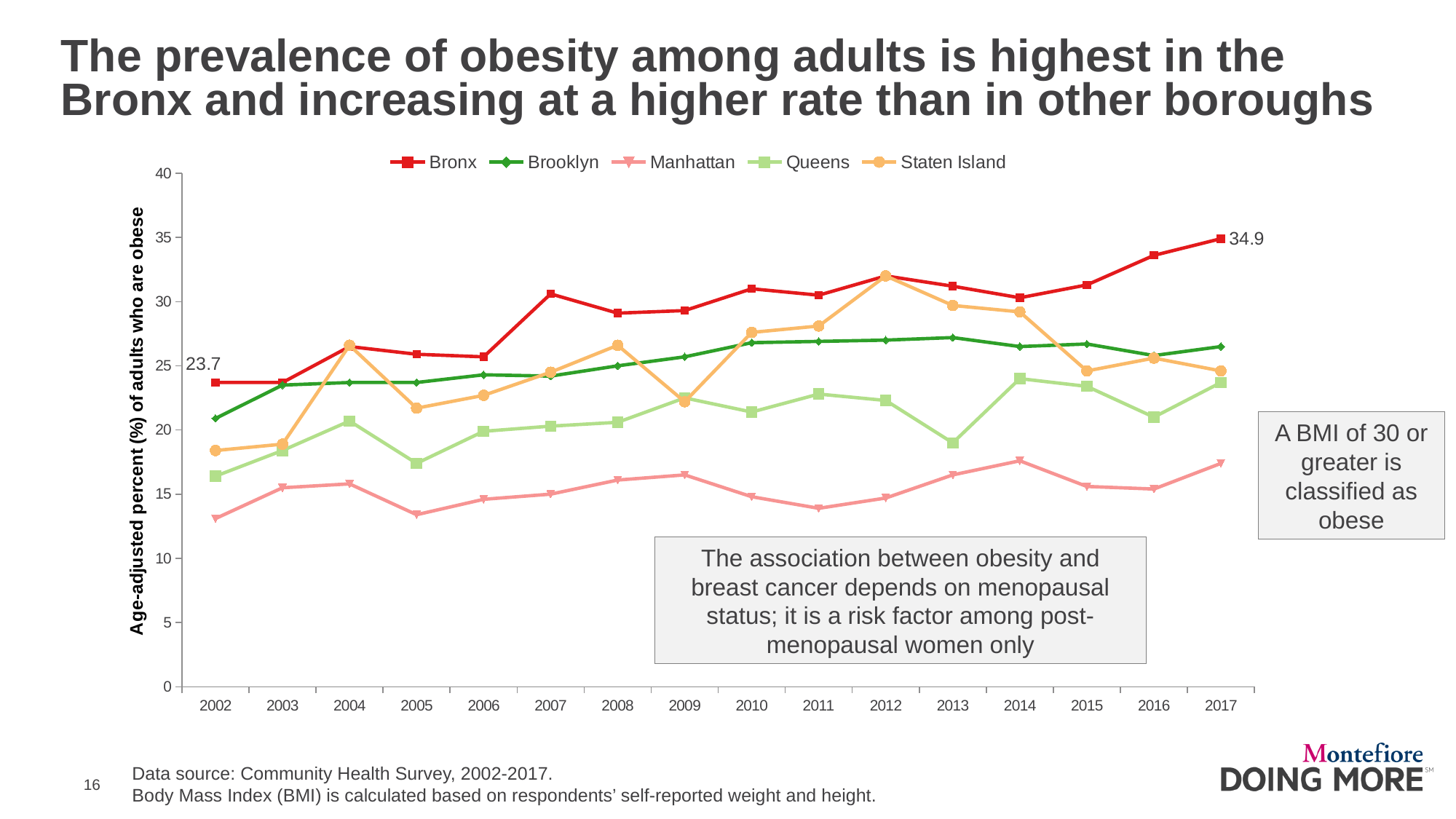
What is the value for the Bronx in 2017? 34.9 Which borough has the highest value in 2017? Bronx Does the Bronx line generally rise or fall from 2002 to 2017? Rise How many years are shown along the x axis? 16 By how much did the Bronx value increase from 2002 to 2017? 11.2 What type of chart is shown on the slide? Line chart In 2010, which is larger, the value for Brooklyn or the value for Queens? Brooklyn Which borough has the lowest value in 2017? Manhattan Is the value for Staten Island in 2012 greater or less than 30? greater What is the value for the Bronx in 2002? 23.7 Is the value for Manhattan in 2017 greater or less than 20? less How many series does the legend list? 5